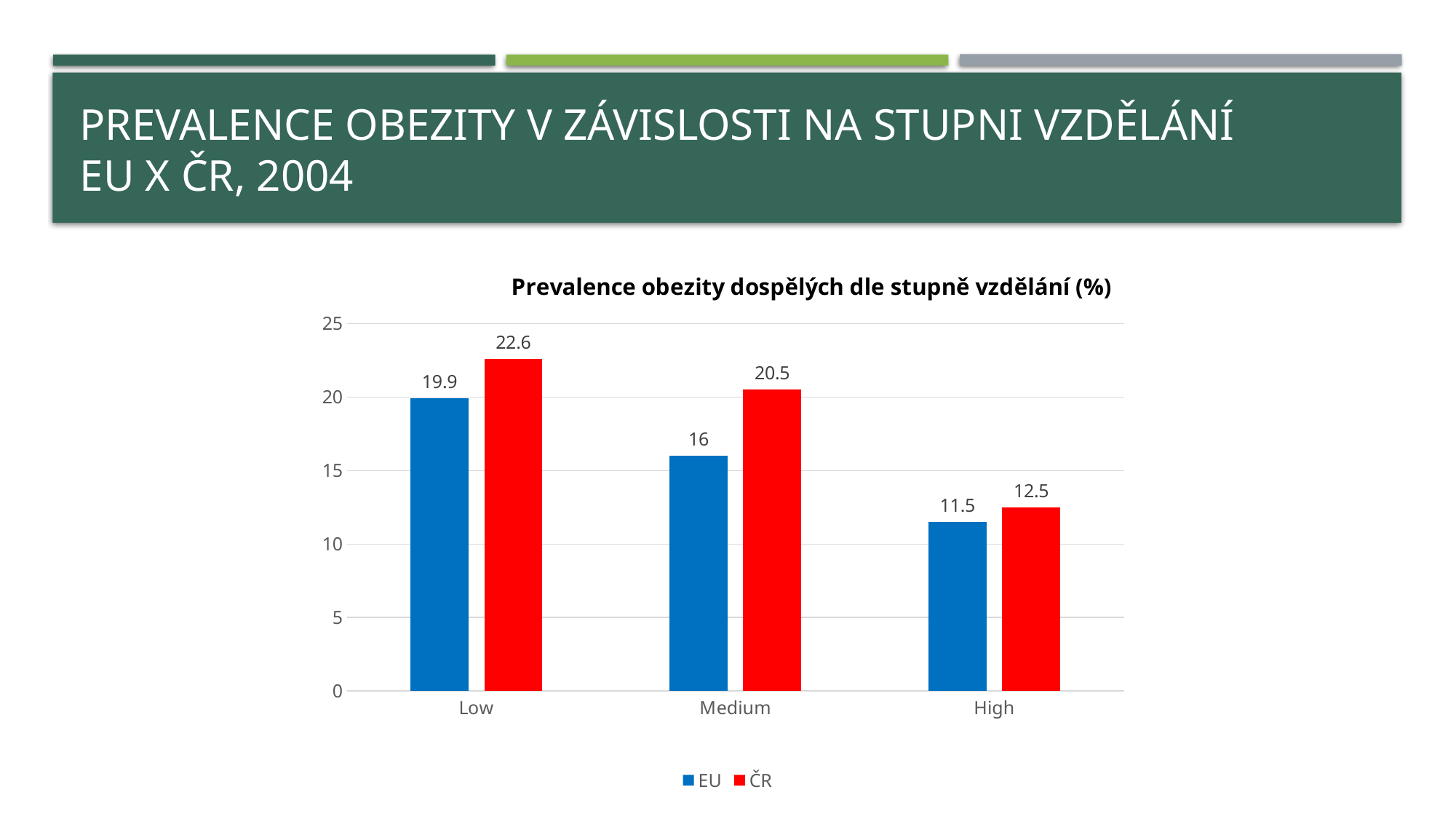
What is the ČR value for the High education level? 12.5 Which education level has the highest ČR value? Low Which education level has the lowest EU value? High What is the ČR value for the Medium education level? 20.5 What is the difference between the ČR and EU values for the Medium education level? 4.5 Which is larger for the High education level, the EU value or the ČR value? ČR How many education levels are shown on the x axis? 3 What is the EU value for the Low education level? 19.9 How many series does the legend list? 2 Do the EU values rise or fall from Low to High education level? Fall What kind of chart is shown on the slide? Bar chart What is the difference between the ČR and EU values for the Low education level? 2.7